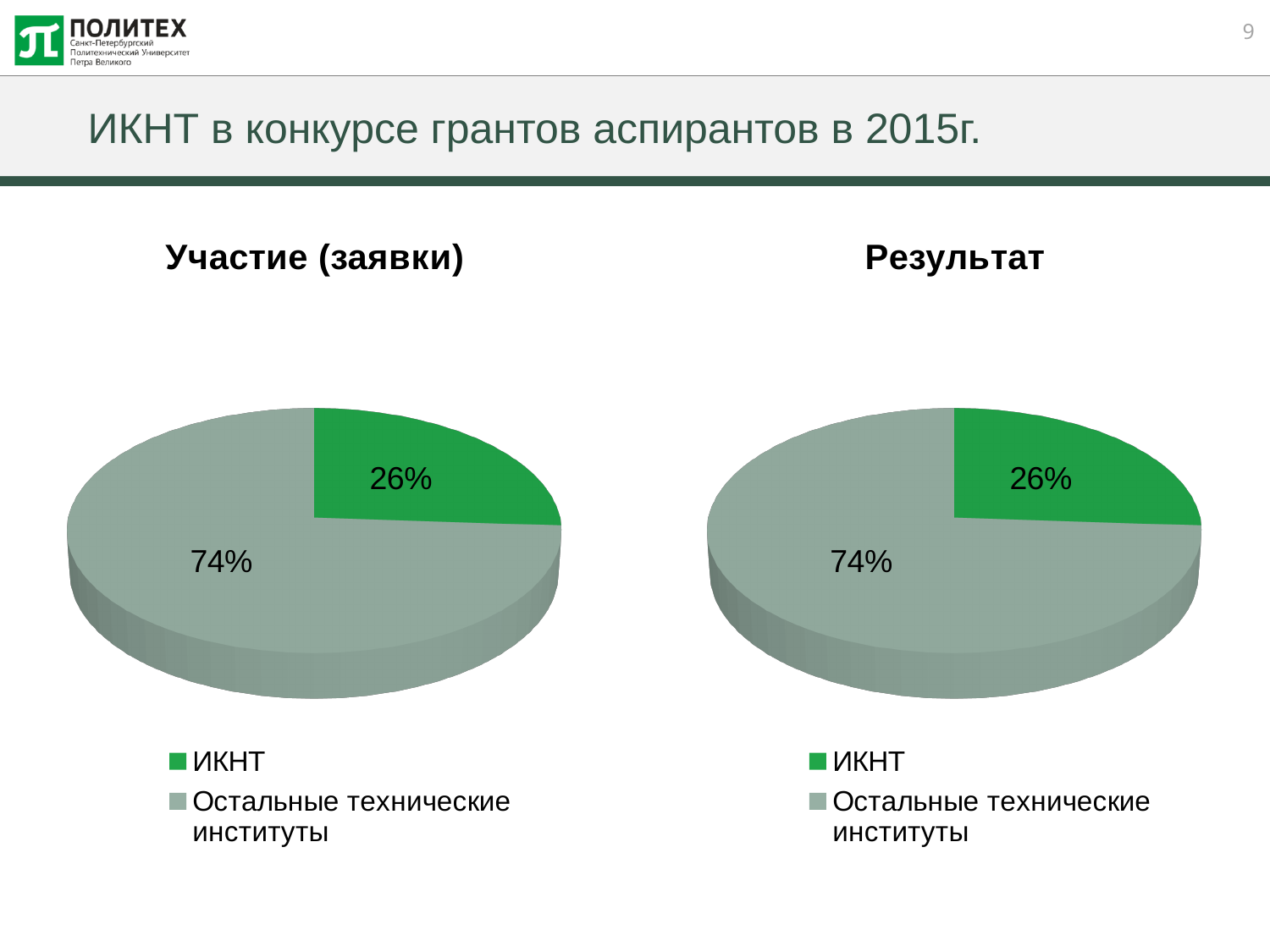
In the 'Результат' chart, what share do Остальные технические институты have? 74% In the 'Результат' chart, which category has the smallest slice? ИКНТ What type of chart is the 'Участие (заявки)' chart? Pie chart In the 'Результат' chart, what colour is the ИКНТ slice? Green In the 'Участие (заявки)' chart, what is the difference between the share of Остальные технические институты and ИКНТ? 48% In the 'Результат' chart, what share does ИКНТ have? 26% In the 'Участие (заявки)' chart, which category has the largest slice? Остальные технические институты In the 'Результат' chart, which is larger: the share of ИКНТ or of Остальные технические институты? Остальные технические институты In the 'Участие (заявки)' chart, what share do Остальные технические институты have? 74% How many slices does the 'Результат' pie chart have? 2 How many entries does the legend of the 'Участие (заявки)' chart list? 2 In the 'Участие (заявки)' chart, what share does ИКНТ have? 26%